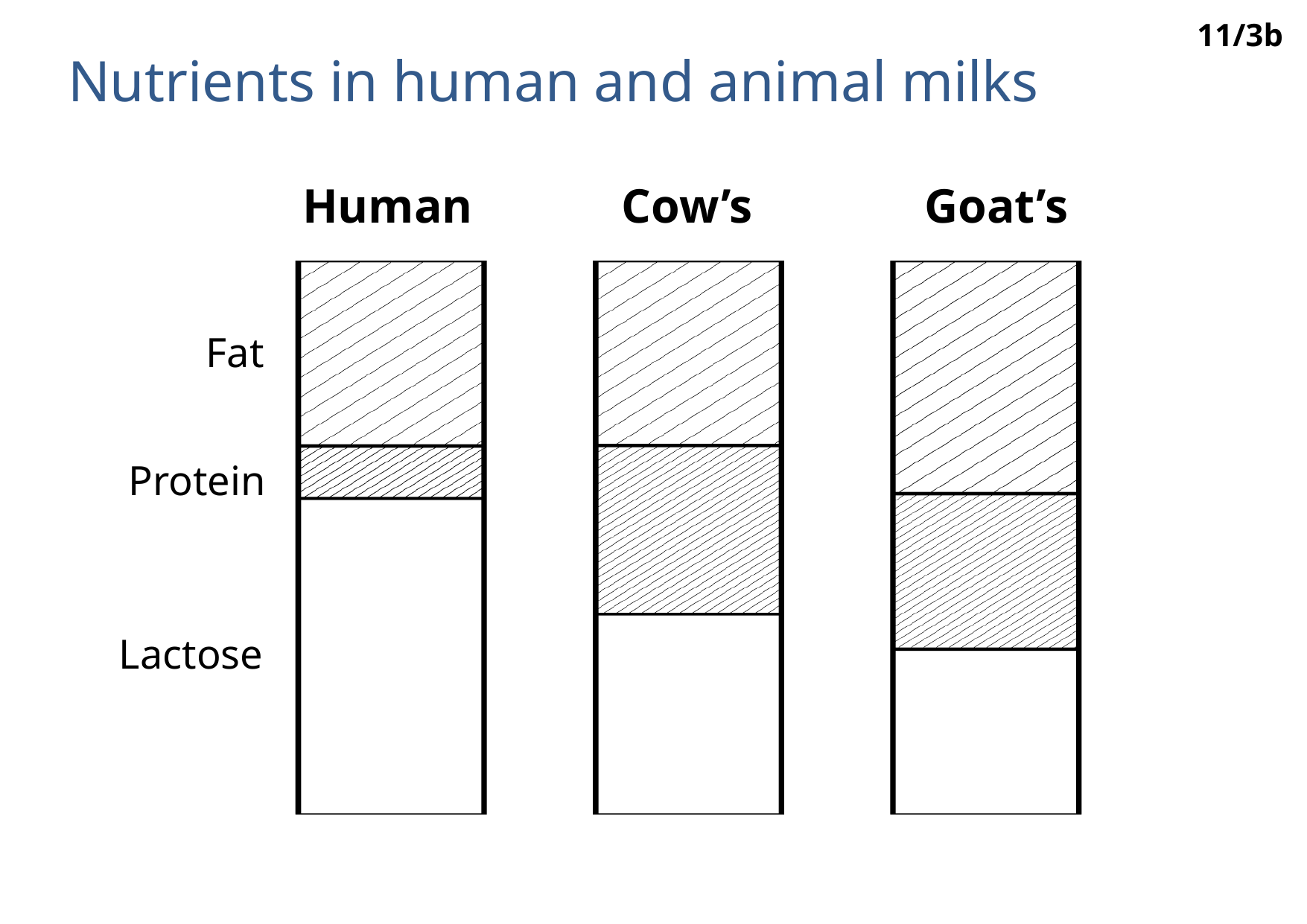
How many milk types (bars) are shown in the chart? 3 Which nutrient is shown at the top of each bar? Fat What kind of chart is shown on the slide? Stacked bar chart Which milk has the smallest Protein segment? Human Which milk has the largest Fat segment? Goat's How many nutrient segments make up each bar? 3 In the Human milk bar, which nutrient has the smallest segment? Protein Which milk has the largest Lactose segment? Human Which is larger, the Protein segment for Human milk or for Cow's milk? Cow's Which is larger, the Lactose segment for Human milk or for Cow's milk? Human What is the title of the chart? Nutrients in human and animal milks Which is larger, the Fat segment for Goat's milk or for Human milk? Goat's